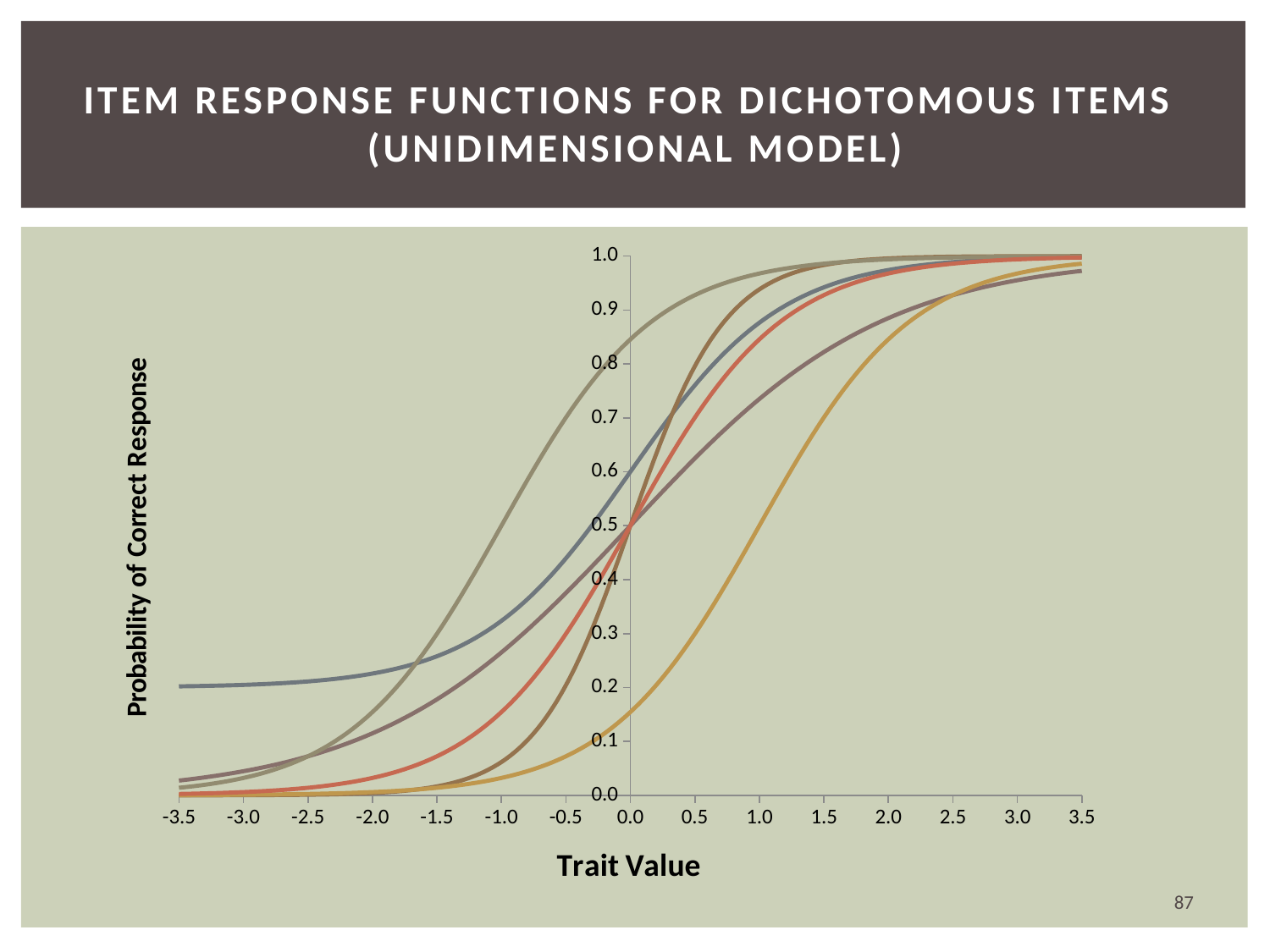
How many curves are plotted on the chart? 6 Is the value of the tan curve at Trait Value 0.0 greater or less than 0.7? greater Which curve has the lowest value at Trait Value 0.0? The orange curve Which curve has the highest value at Trait Value -3.5? The blue-gray curve What is the title of the x axis? Trait Value What kind of chart is shown on the slide? Line chart What is the title of the y axis? Probability of Correct Response Do the curves rise or fall as Trait Value increases? Rise Is the value of the blue-gray curve at Trait Value -3.5 greater or less than 0.1? greater Is the value of the orange curve at Trait Value 0.0 greater or less than 0.5? less What is the highest value shown on the y axis? 1.0 What is the lowest Trait Value shown on the x axis? -3.5